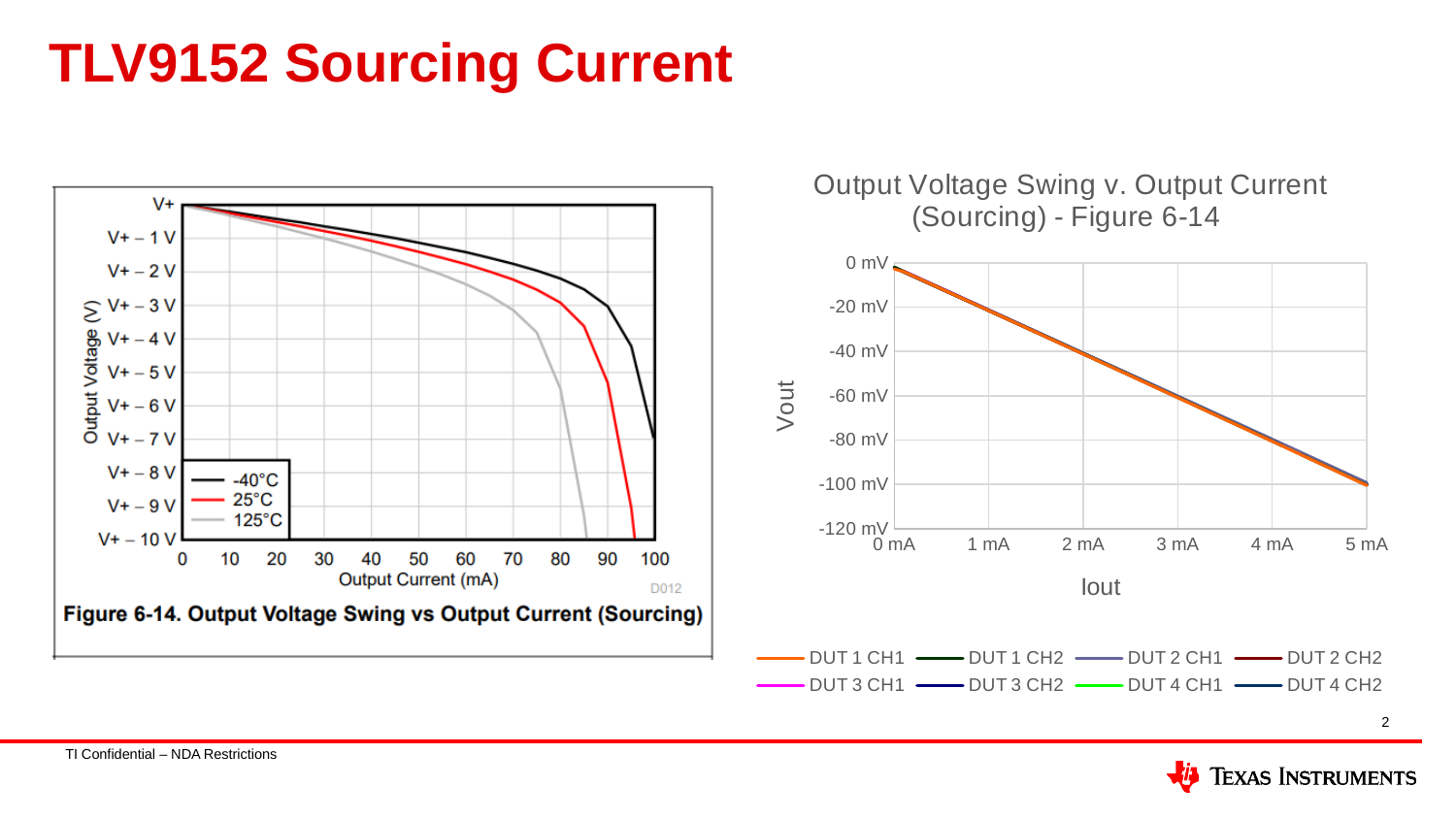
In the right-hand chart, is the Vout value at 3 mA greater or less than -40 mV? less In the left-hand chart (Figure 6-14 from the datasheet), does the output voltage rise or fall as output current increases? Fall In the right-hand chart titled 'Output Voltage Swing v. Output Current (Sourcing) - Figure 6-14', how many series does the legend list? 8 In the left-hand chart (Figure 6-14 from the datasheet), at 90 mA output current, which curve has the higher output voltage: -40°C or 25°C? -40°C In the left-hand chart (Figure 6-14 from the datasheet), which temperature curve reaches V+ – 10 V at the lowest output current? 125°C In the right-hand chart, does Vout rise or fall as Iout increases from 0 mA to 5 mA? Fall In the right-hand chart, what is the label of the vertical axis? Vout In the right-hand chart, what is the first series listed in the legend? DUT 1 CH1 In the left-hand chart (Figure 6-14 from the datasheet), how many temperature series does the legend list? 3 What kind of chart is the right-hand chart titled 'Output Voltage Swing v. Output Current (Sourcing) - Figure 6-14'? Line chart In the right-hand chart, is the Vout value at 1 mA greater or less than -60 mV? greater In the left-hand chart (Figure 6-14 from the datasheet), what is the maximum value shown on the Output Current axis? 100